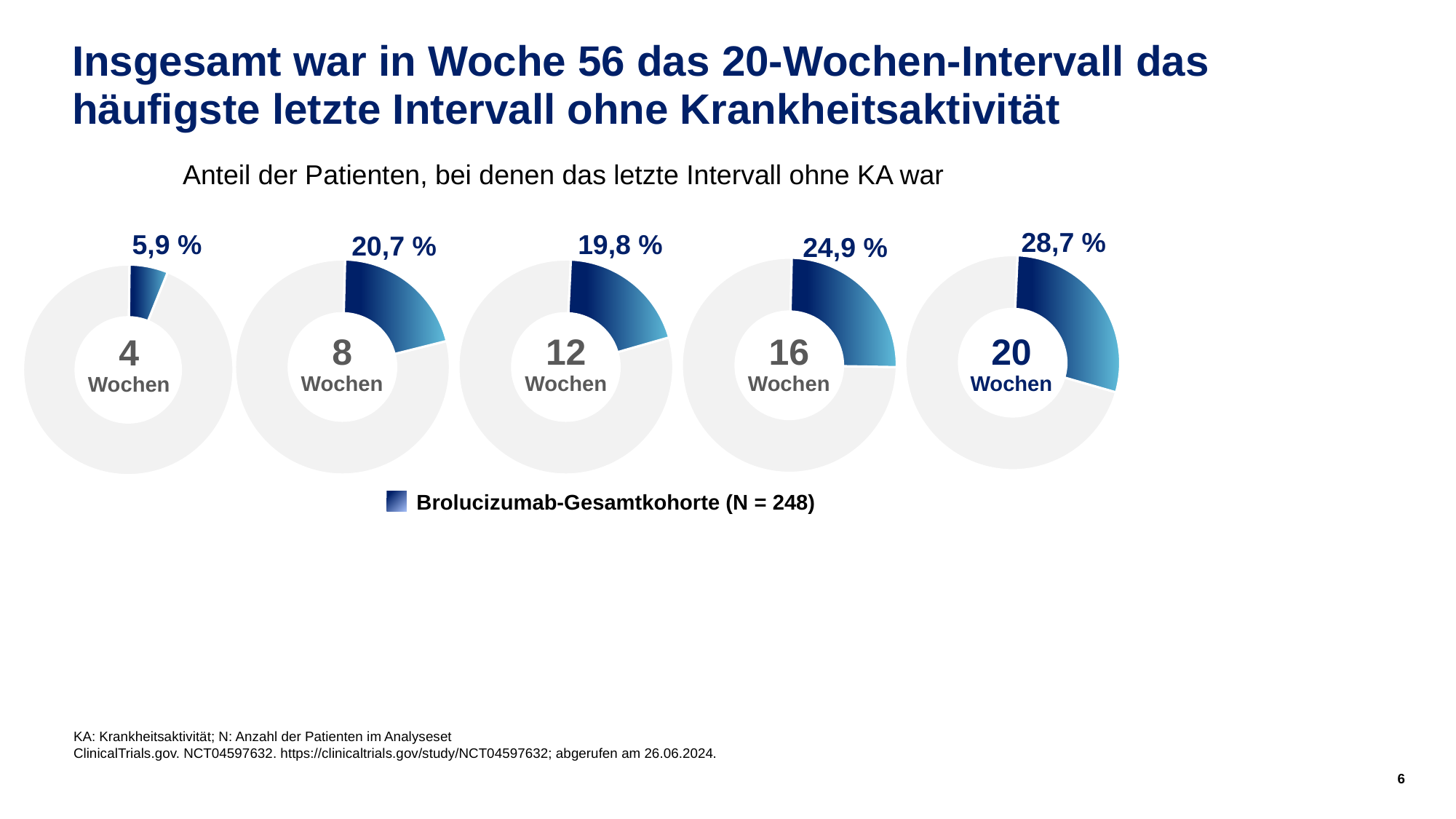
Across the five donut charts, which interval has the lowest share of patients? 4 Wochen How many series does the legend below the donut charts list? 1 Comparing the 8 Wochen and 12 Wochen donut charts, which shows the larger value? 8 Wochen In the 20 Wochen donut chart, what percentage of patients is shown? 28,7 % How many donut charts are shown on the slide? 5 In the 16 Wochen donut chart, what value is printed above the chart? 24,9 % What kind of chart is used to show the share of patients for each interval? Donut chart What is the difference between the value in the 20 Wochen donut chart and the value in the 4 Wochen donut chart? 22,8 % In the 12 Wochen donut chart, what value is printed above the chart? 19,8 % In the 4 Wochen donut chart, what percentage of patients is shown? 5,9 % What is the legend entry shown below the donut charts? Brolucizumab-Gesamtkohorte (N = 248) Across the five donut charts, which interval has the highest share of patients? 20 Wochen